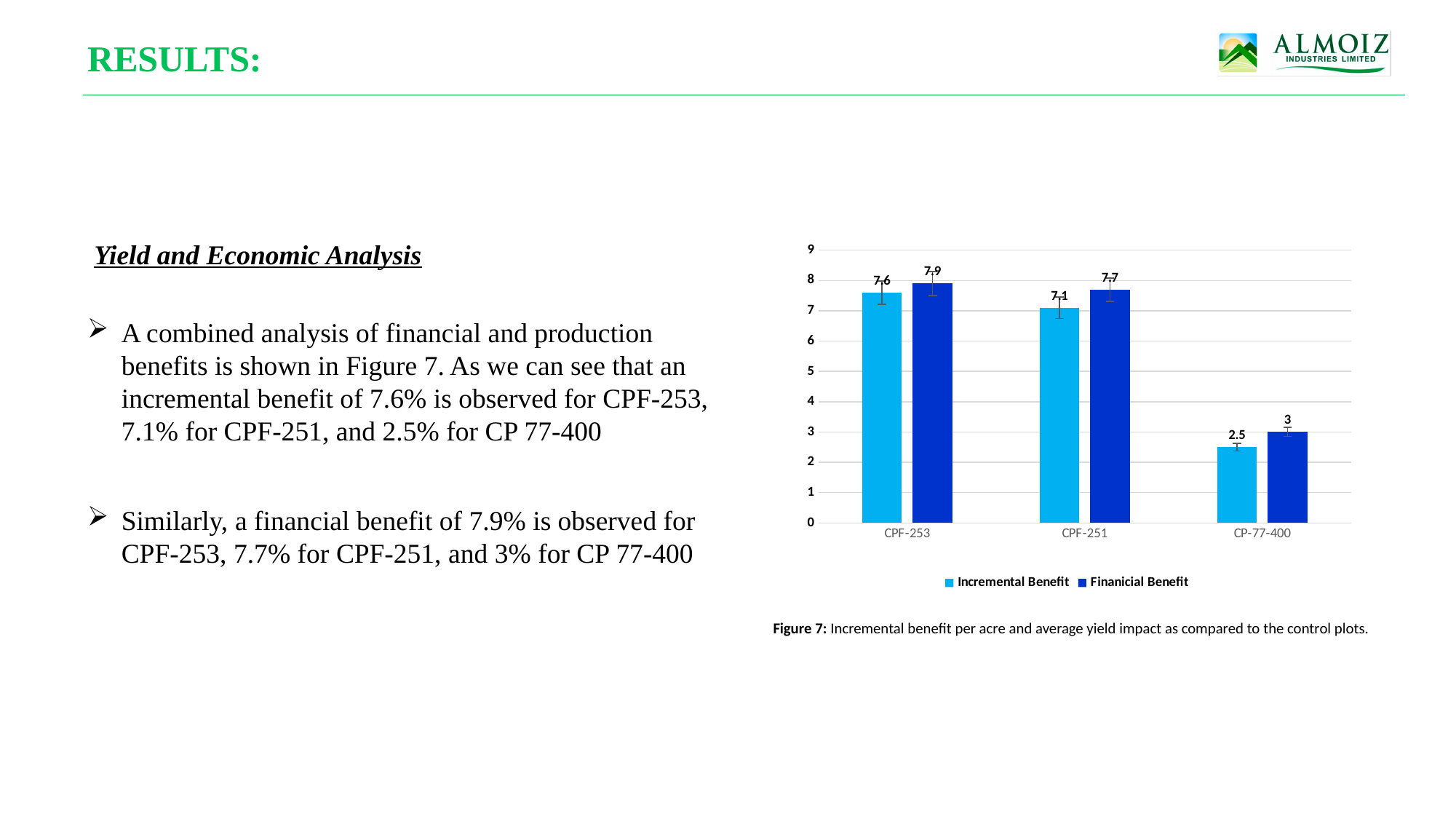
What is the difference between the Finanicial Benefit and the Incremental Benefit for CPF-251? 0.6 Is the Finanicial Benefit value for CP-77-400 greater or less than 5? less Which category has the highest Finanicial Benefit? CPF-253 What is the Incremental Benefit value for CPF-253? 7.6 What is the Finanicial Benefit value for CP-77-400? 3 How many categories are shown on the x axis? 3 How many series does the legend list? 2 What is the difference between the Incremental Benefit for CPF-253 and for CP-77-400? 5.1 What kind of chart is shown on the slide? Bar chart Which is larger, the Incremental Benefit for CPF-253 or the Incremental Benefit for CPF-251? CPF-253 What is the Finanicial Benefit value for CPF-251? 7.7 Which category has the lowest Incremental Benefit? CP-77-400